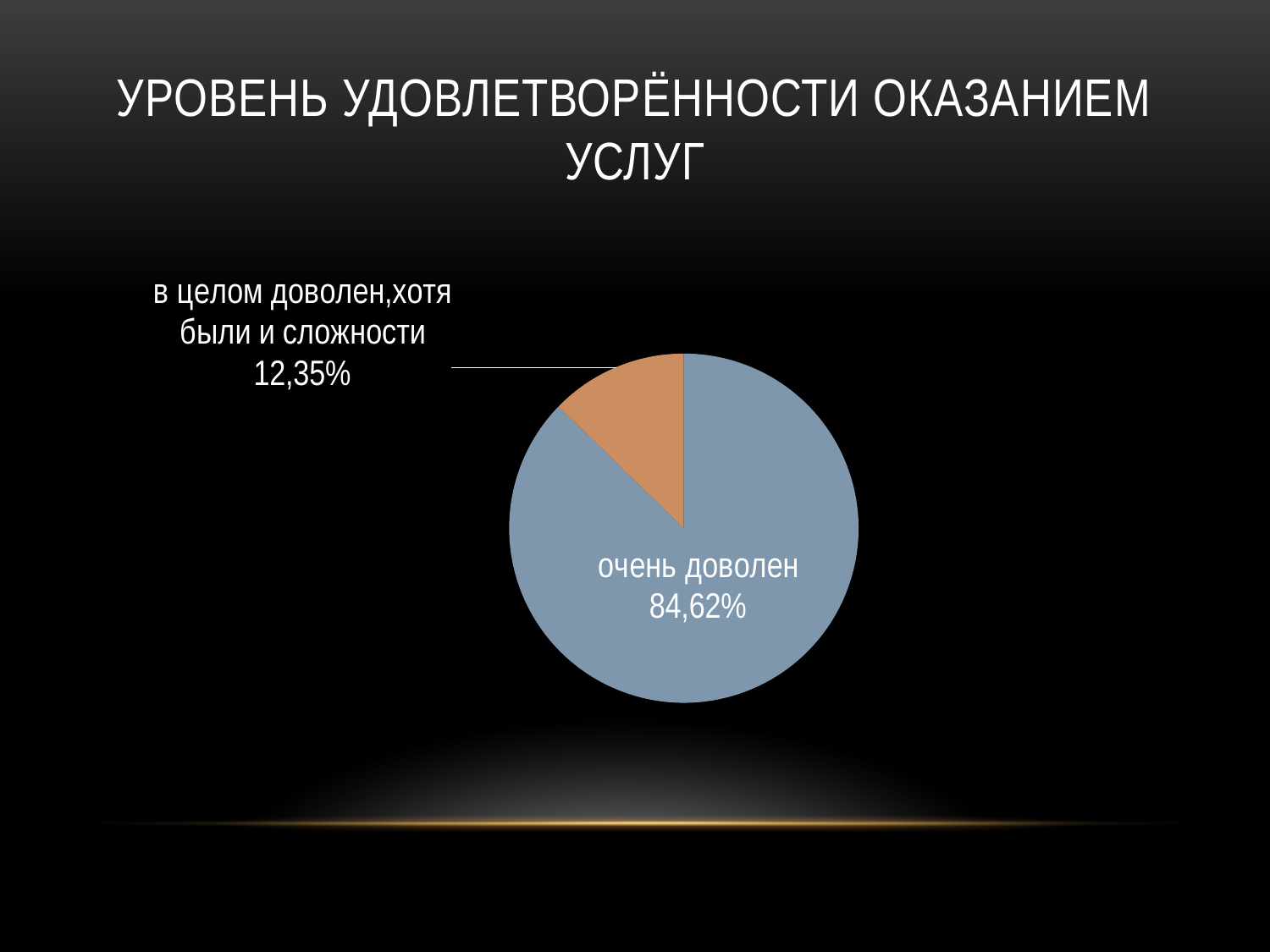
What percentage is shown for the slice "очень доволен"? 84,62% Which slice of the pie chart is the smallest? в целом доволен,хотя были и сложности What is the title of the chart on the slide? Уровень удовлетворённости оказанием услуг What is the difference in percentage points between the "очень доволен" slice and the "в целом доволен,хотя были и сложности" slice? 72,27% What colour is the "в целом доволен,хотя были и сложности" slice? Orange How many slices does the pie chart have? 2 What kind of chart is shown on the slide? Pie chart Which is larger: the share for "очень доволен" or the share for "в целом доволен,хотя были и сложности"? очень доволен Which slice of the pie chart is the largest? очень доволен What share of the pie does the "очень доволен" slice represent? 84,62% What percentage is shown for the slice "в целом доволен,хотя были и сложности"? 12,35%